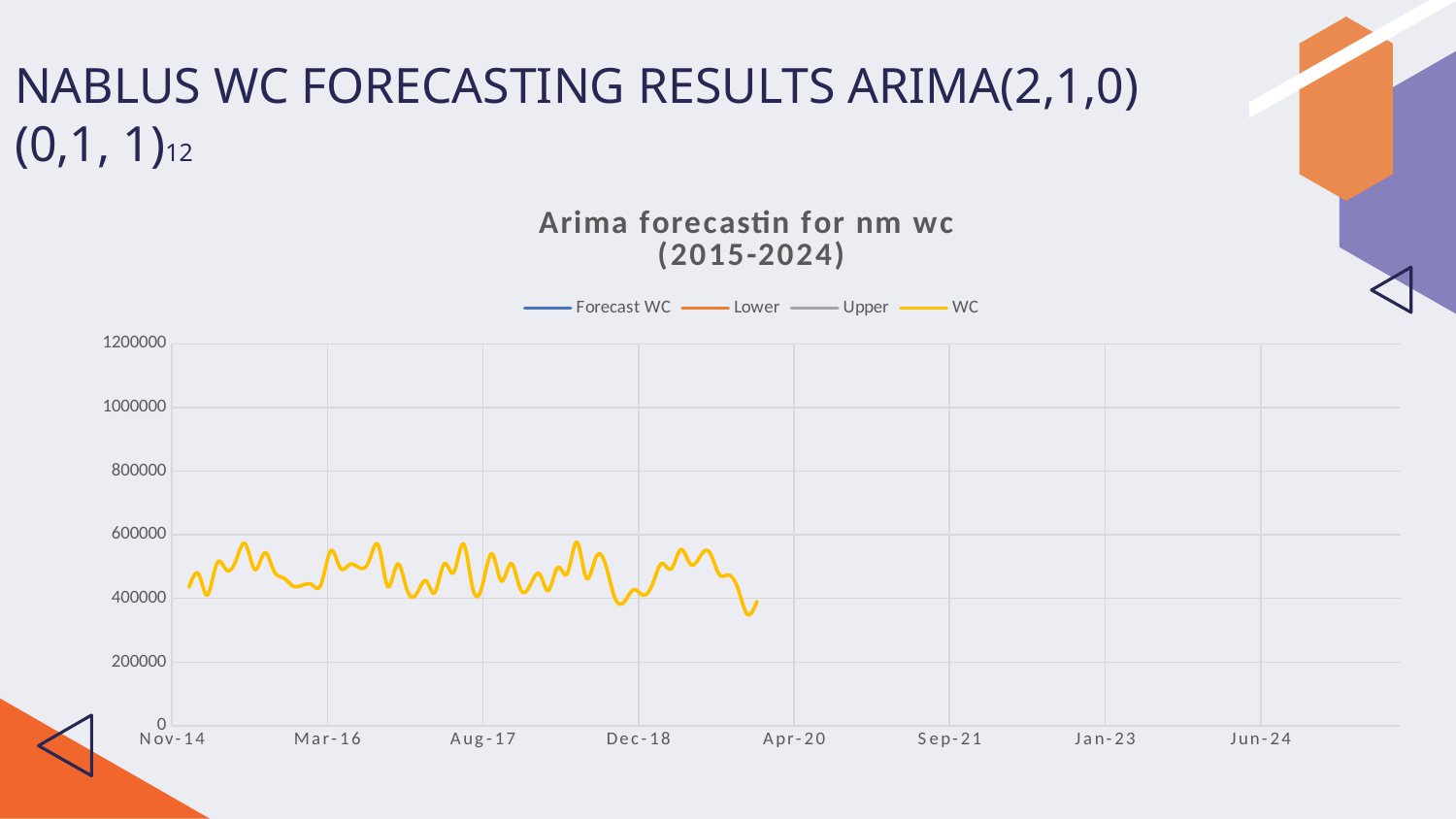
Is the lowest point of the WC line greater or less than 200000? greater What is the title of the chart? Arima forecastin for nm wc (2015-2024) How many series does the legend of the chart list? 4 Is the WC value around Mar-16 greater or less than 200000? greater What kind of chart is shown on the slide? line chart How many date labels are shown on the x axis of the chart? 8 What is the highest value shown on the y axis of the chart? 1200000 Which series names are listed in the chart legend? Forecast WC, Lower, Upper, WC Is the WC value around Dec-18 greater or less than 800000? less Does the WC line extend past Apr-20 on the x axis? No